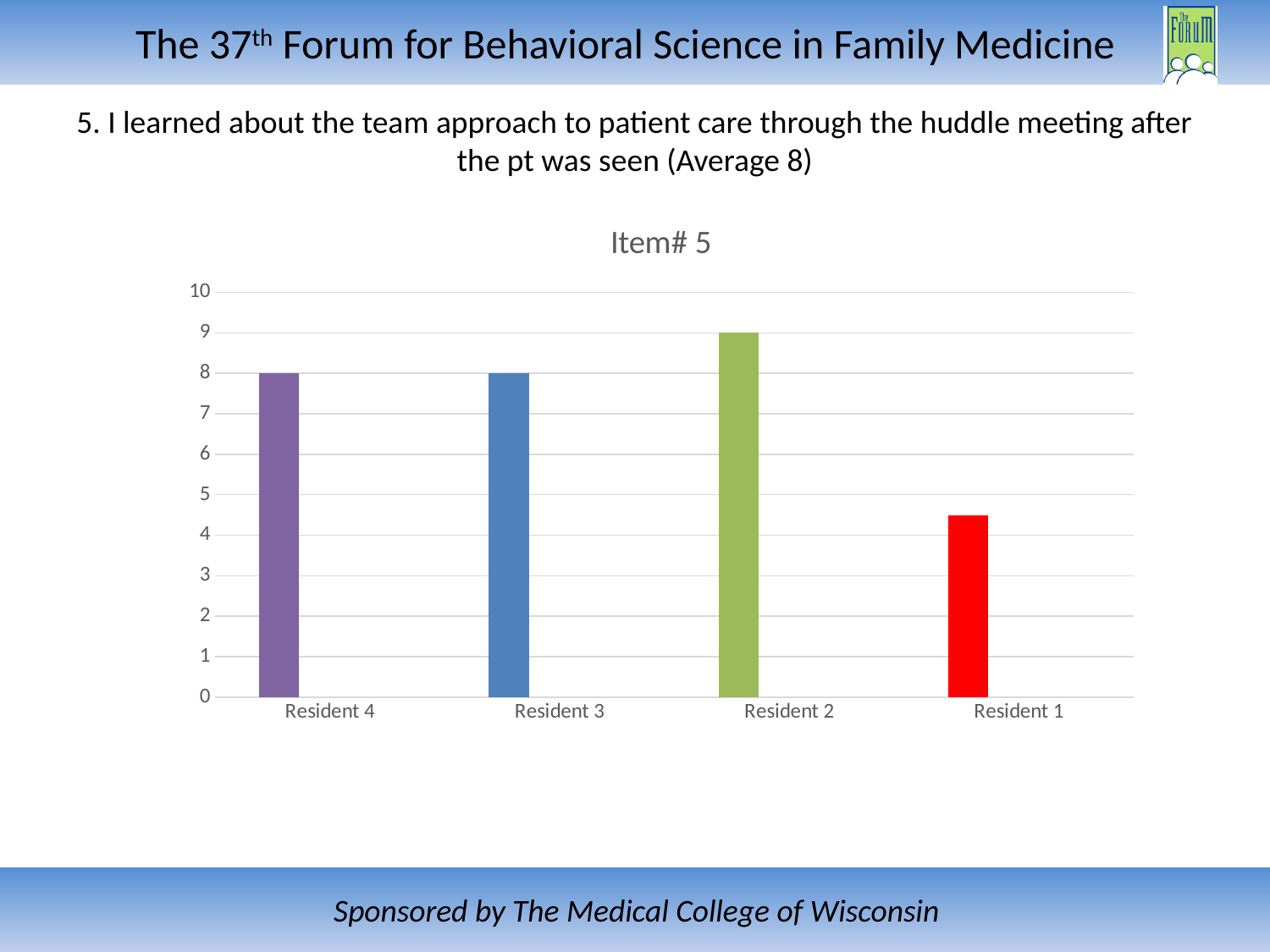
Which resident has the highest value? Resident 2 How many residents are shown on the chart? 4 What is the value for Resident 2? 9 Which resident has the lowest value? Resident 1 What kind of chart is shown on the slide? bar chart What is the title of the chart? Item# 5 Is the value for Resident 1 greater or less than 4? greater What is the value for Resident 3? 8 Which is larger, the value for Resident 2 or the value for Resident 1? Resident 2 What is the difference between the values for Resident 2 and Resident 4? 1 What is the value for Resident 4? 8 Is the value for Resident 1 greater or less than 5? less